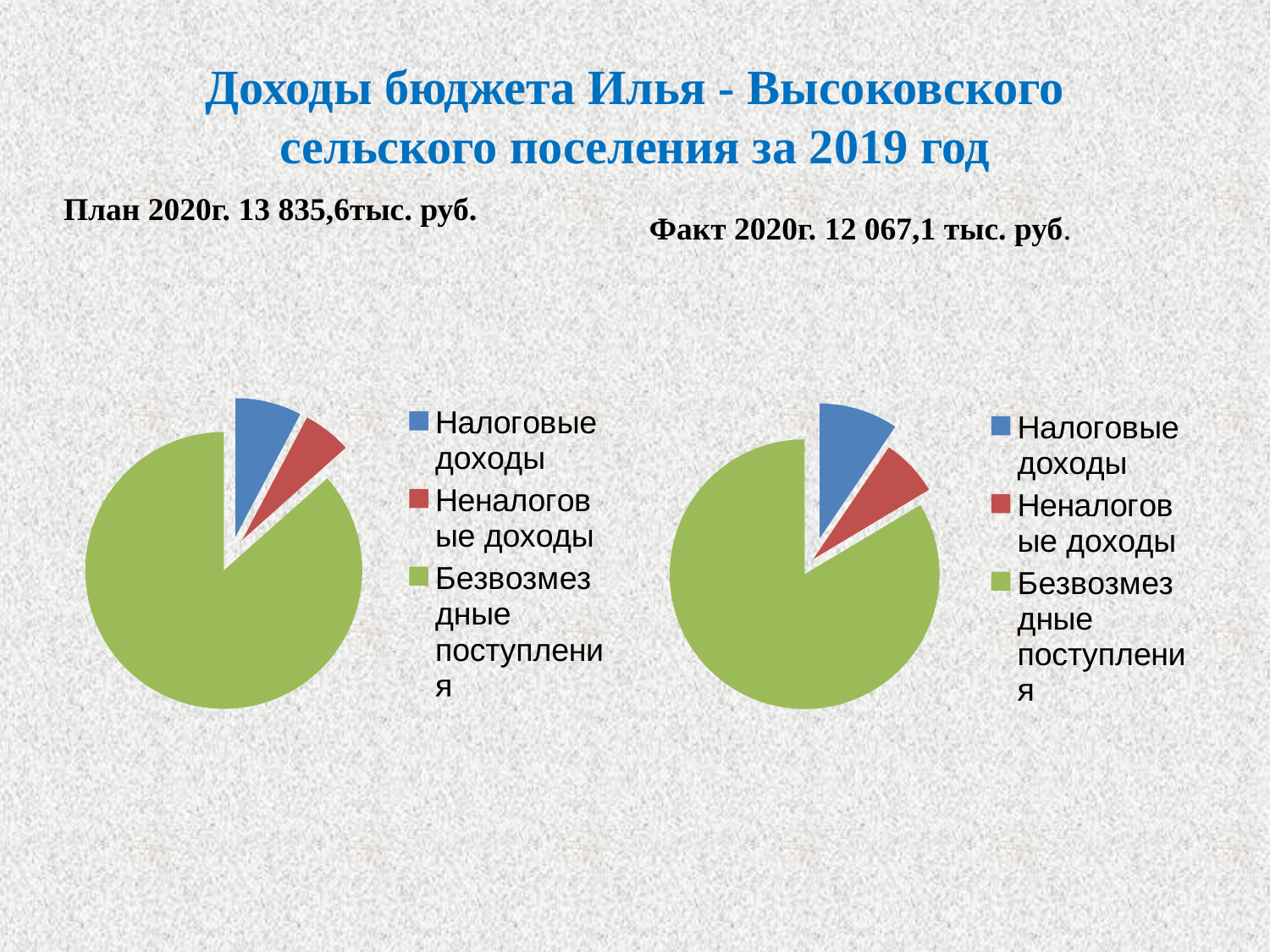
In the right chart (Факт 2020г.), which category has the largest slice? Безвозмездные поступления How many slices does the left pie chart (План 2020г.) have? 3 In the left chart (План 2020г.), which slice is larger: Налоговые доходы or Безвозмездные поступления? Безвозмездные поступления In the left chart (План 2020г.), which category has the largest slice? Безвозмездные поступления In the right chart (Факт 2020г.), which category has the smallest slice? Неналоговые доходы What total amount is stated in the heading above the right chart (Факт 2020г.)? 12 067,1 тыс. руб. What kind of chart is the right chart (Факт 2020г.)? pie chart In the left chart (План 2020г.), which category has the smallest slice? Неналоговые доходы How many entries does the legend of the right chart (Факт 2020г.) list? 3 What kind of chart is the left chart (План 2020г.)? pie chart What colour represents Безвозмездные поступления in the legend of the left chart? green In the right chart (Факт 2020г.), which slice is larger: Налоговые доходы or Неналоговые доходы? Налоговые доходы